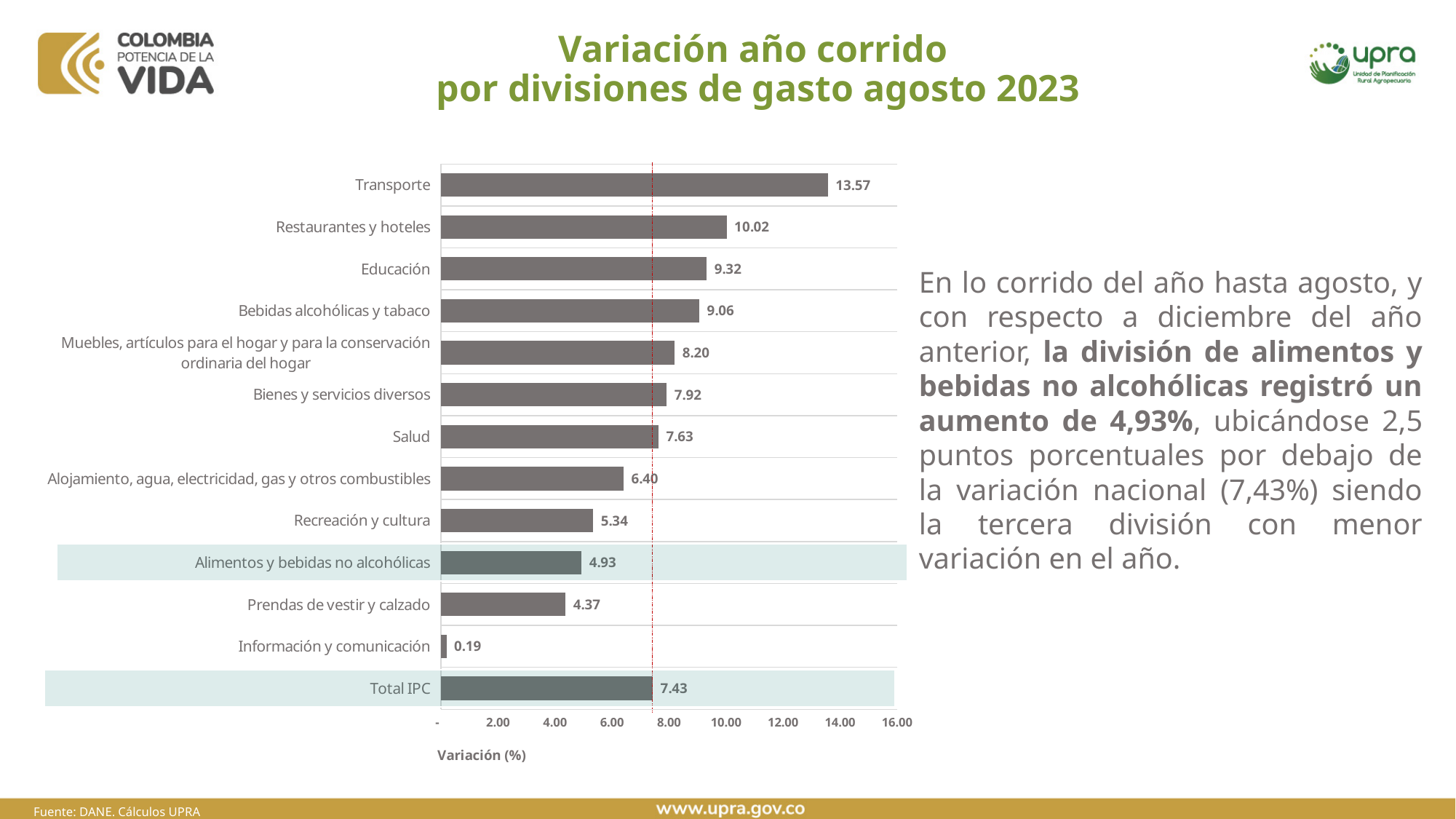
What is the value for Total IPC? 7.43 What is the difference between the values for Transporte and Restaurantes y hoteles? 3.55 Which category has the lowest value? Información y comunicación What is the value for Transporte? 13.57 Which is larger, the value for Salud or the value for Recreación y cultura? Salud What is the value for Prendas de vestir y calzado? 4.37 Which category has the highest value? Transporte What is the value for Alimentos y bebidas no alcohólicas? 4.93 What kind of chart is shown on the slide? Bar chart How many categories are shown on the chart? 13 What is the label of the horizontal axis? Variación (%) Is the value for Educación greater or less than 8.00? greater